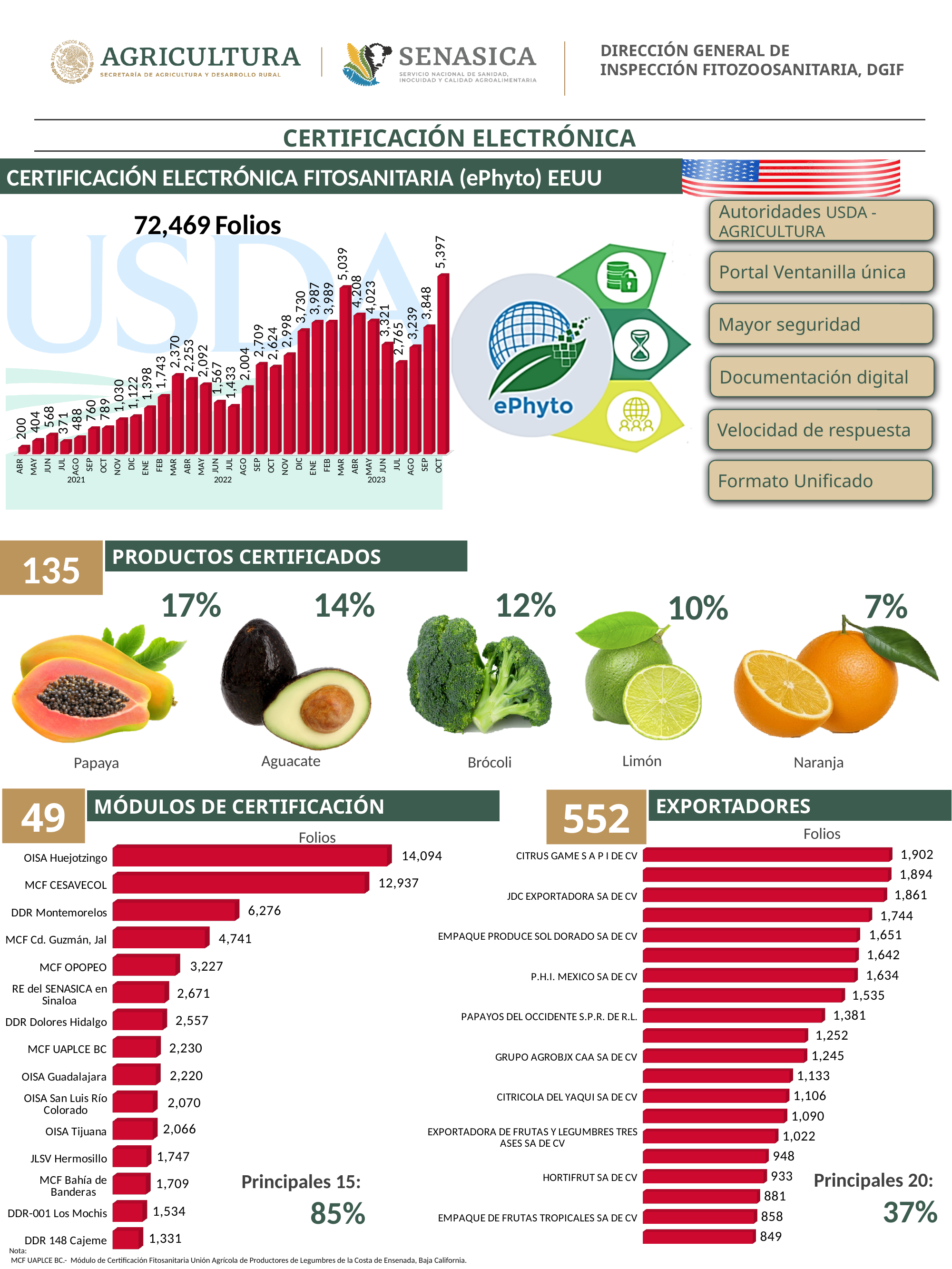
In the monthly ePhyto folios chart at the top left, what value is shown for OCT 2023? 5,397 In the 'Exportadores' chart, which is larger: HORTIFRUT SA DE CV or CITRICOLA DEL YAQUI SA DE CV? CITRICOLA DEL YAQUI SA DE CV In the 'Exportadores' chart, what is the value for PAPAYOS DEL OCCIDENTE S.P.R. DE R.L.? 1,381 In the monthly ePhyto folios chart at the top left, how many monthly bars are plotted? 31 In the monthly ePhyto folios chart at the top left, what is the difference between MAR 2023 and FEB 2023? 1,050 In the 'Módulos de certificación' chart, which module has the highest number of folios? OISA Huejotzingo What kind of chart is the 'Exportadores' chart? Bar chart In the 'Módulos de certificación' chart, what is the difference between OISA Huejotzingo and DDR Montemorelos? 7,818 In the monthly ePhyto folios chart at the top left, what total number of folios is stated above the chart? 72,469 Folios In the 'Módulos de certificación' chart, what is the value for MCF CESAVECOL? 12,937 In the monthly ePhyto folios chart at the top left, which month has the lowest value? ABR 2021 In the 'Módulos de certificación' chart, how many modules are listed? 15